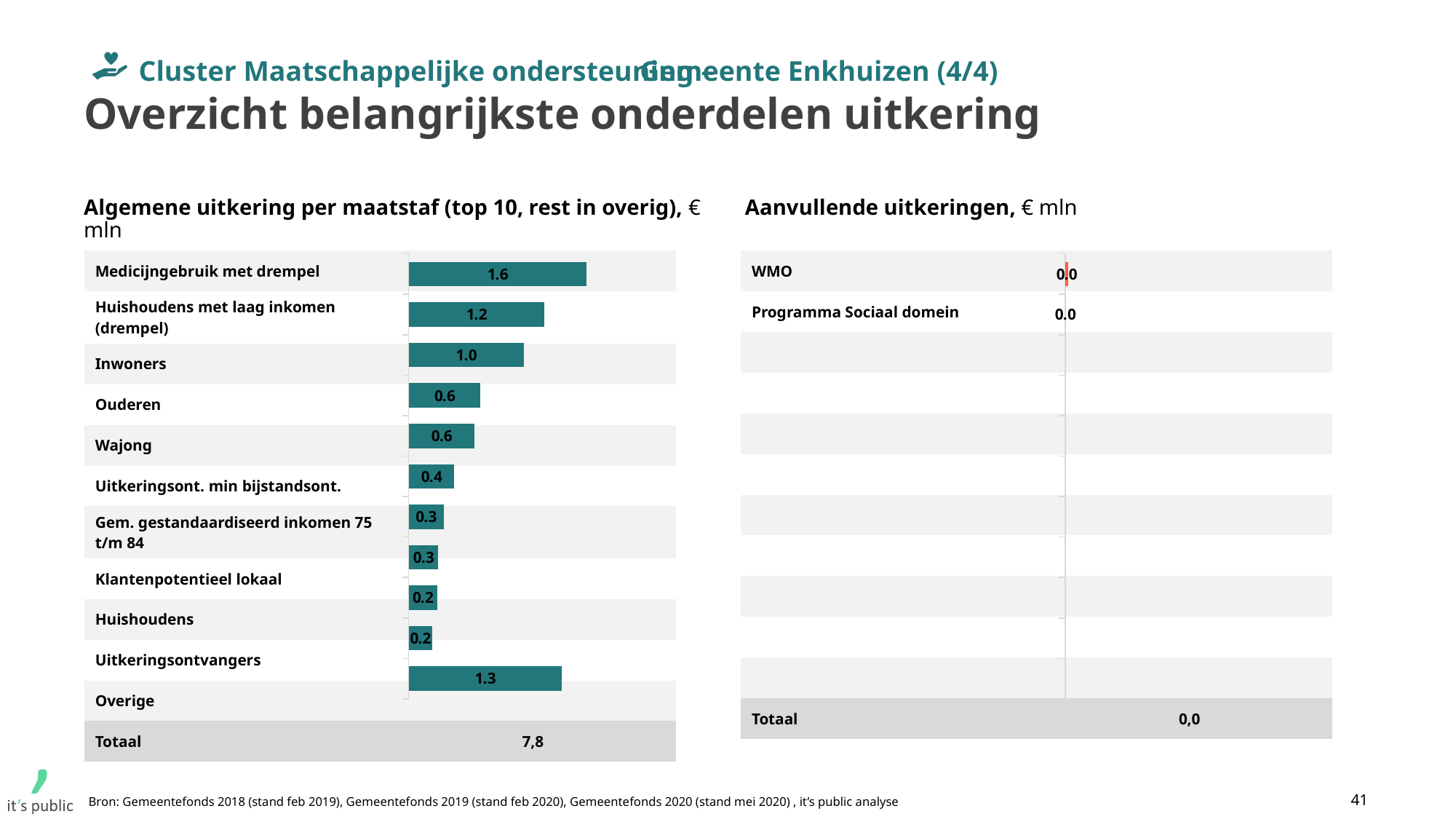
In the 'Algemene uitkering per maatstaf' chart, which category has the highest value? Medicijngebruik met drempel In the 'Algemene uitkering per maatstaf' chart, what is the value for Overige? 1.3 What unit is stated in the title of the 'Aanvullende uitkeringen' chart? € mln What kind of chart is the 'Algemene uitkering per maatstaf' chart? Bar chart In the 'Aanvullende uitkeringen' chart, what is the value for WMO? 0.0 In the 'Algemene uitkering per maatstaf' chart, which is larger: Inwoners or Ouderen? Inwoners How many categories (excluding Totaal) are shown in the 'Algemene uitkering per maatstaf' chart? 11 In the 'Algemene uitkering per maatstaf' chart, what is the value for Medicijngebruik met drempel? 1.6 In the 'Algemene uitkering per maatstaf' chart, what is the Totaal shown? 7,8 In the 'Algemene uitkering per maatstaf' chart, what is the difference between Medicijngebruik met drempel and Huishoudens met laag inkomen (drempel)? 0.4 In the 'Algemene uitkering per maatstaf' chart, what is the value for Inwoners? 1.0 In the 'Aanvullende uitkeringen' chart, what is the Totaal shown? 0,0